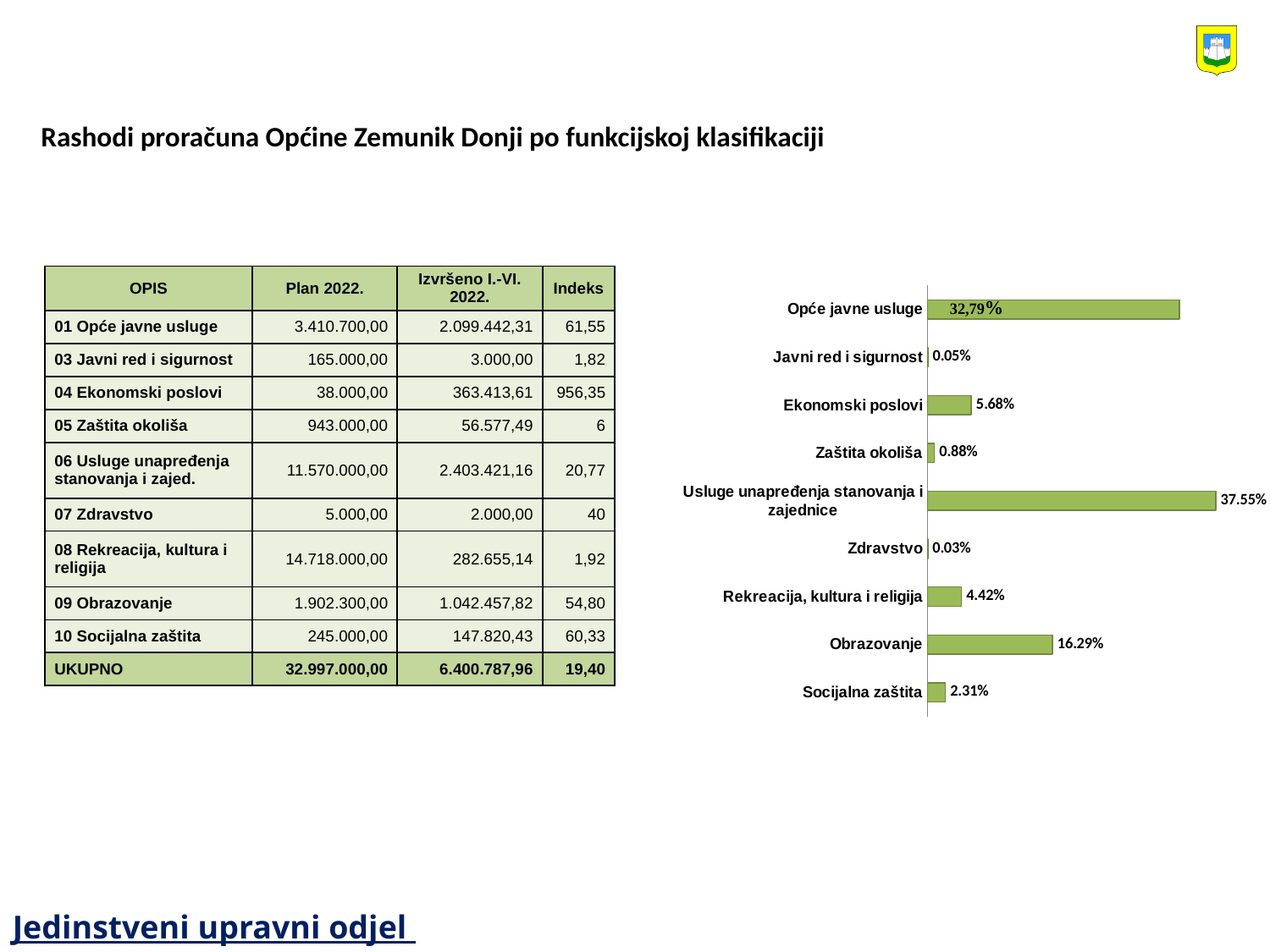
What is the value shown for Zaštita okoliša in the bar chart? 0.88% What is the value shown for Ekonomski poslovi in the bar chart? 5.68% What is the difference between the values for Obrazovanje and Ekonomski poslovi in the bar chart? 10.61% What is the value shown for Usluge unapređenja stanovanja i zajednice in the bar chart? 37.55% What is the value shown for Obrazovanje in the bar chart? 16.29% Which category has the lowest value in the bar chart? Zdravstvo In the bar chart, which is larger: Obrazovanje or Rekreacija, kultura i religija? Obrazovanje Which category has the highest value in the bar chart? Usluge unapređenja stanovanja i zajednice What is the value shown for Javni red i sigurnost in the bar chart? 0.05% What is the value shown for Socijalna zaštita in the bar chart? 2.31% What kind of chart is shown on the slide? bar chart How many categories are plotted in the bar chart? 9